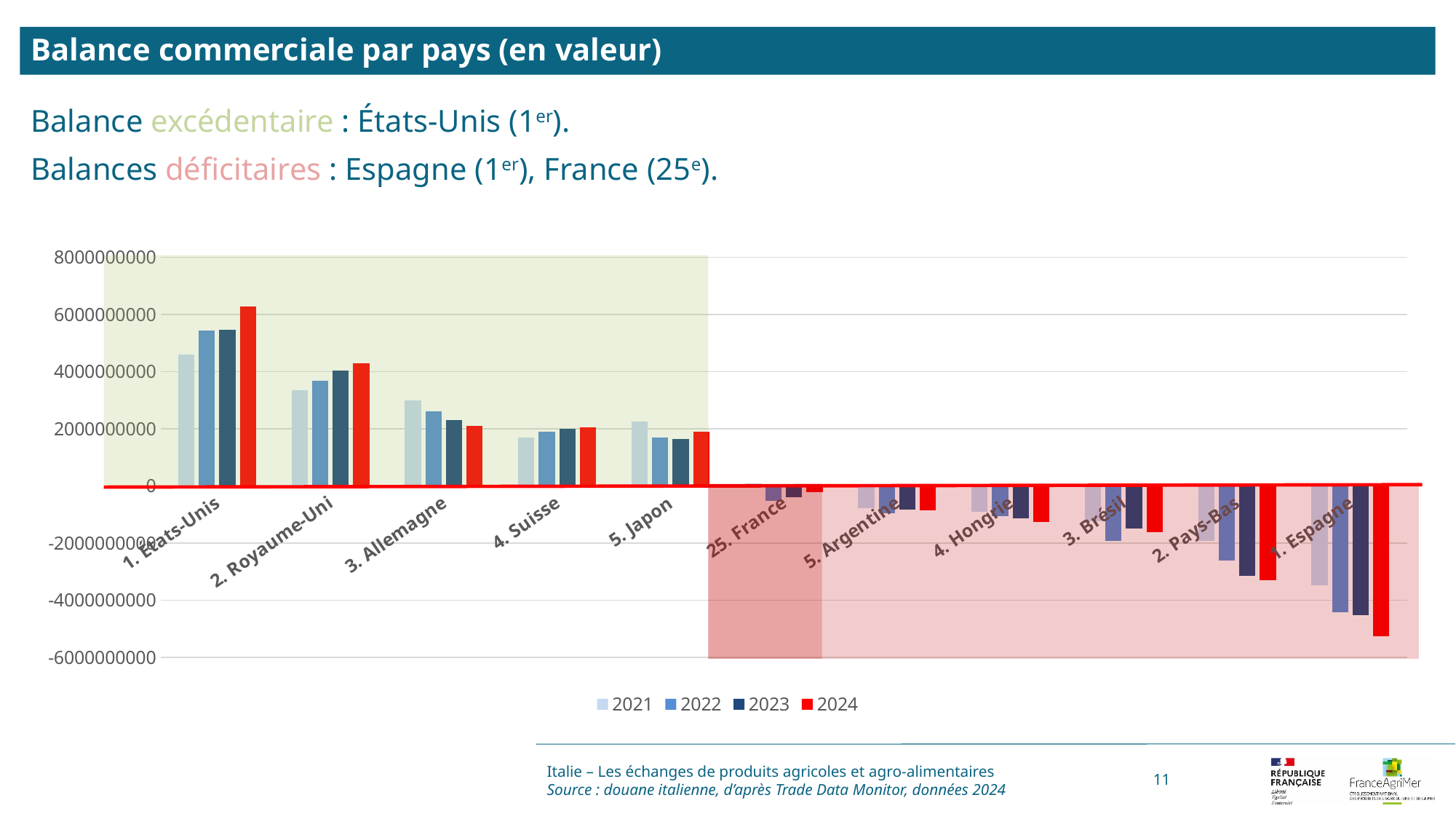
Is the 2024 value for 2. Royaume-Uni greater or less than 4000000000? greater Is the 2024 value for 1. Espagne greater or less than -4000000000? less What kind of chart is shown on the slide? bar chart Is the 2021 value for 4. Suisse greater or less than 2000000000? less Which colour represents the 2024 series in the chart legend? red Which country has the highest 2024 value in the chart? 1. États-Unis Do the values for 3. Allemagne rise or fall from 2021 to 2024? fall Which country has the lowest (most negative) 2024 value in the chart? 1. Espagne Which is larger, the 2024 value for 1. États-Unis or the 2024 value for 2. Royaume-Uni? 1. États-Unis How many series does the chart legend list? 4 How many countries (categories) are shown on the x axis of the chart? 11